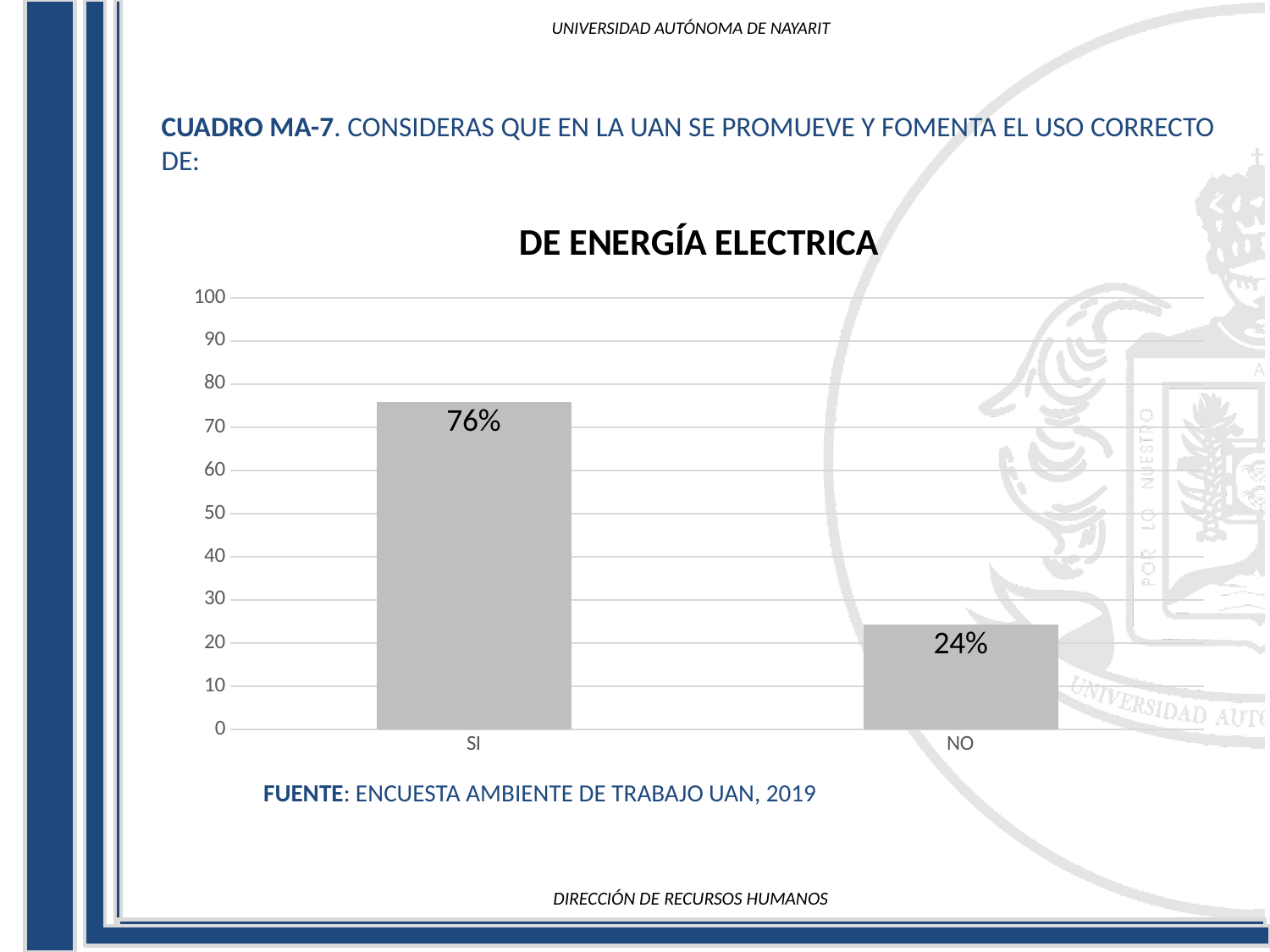
What is the difference between the values for SI and NO? 52% Which category has the lowest value? NO How many categories are shown on the x axis? 2 What kind of chart is shown on the slide? bar chart What is the highest value shown on the vertical axis? 100 Which category has the highest value? SI What is the value for SI? 76% What is the value for NO? 24% Is the value for SI greater or less than 50? greater Is the value for NO greater or less than 30? less What is the title of the chart? DE ENERGÍA ELECTRICA Which is larger, the value for SI or the value for NO? SI